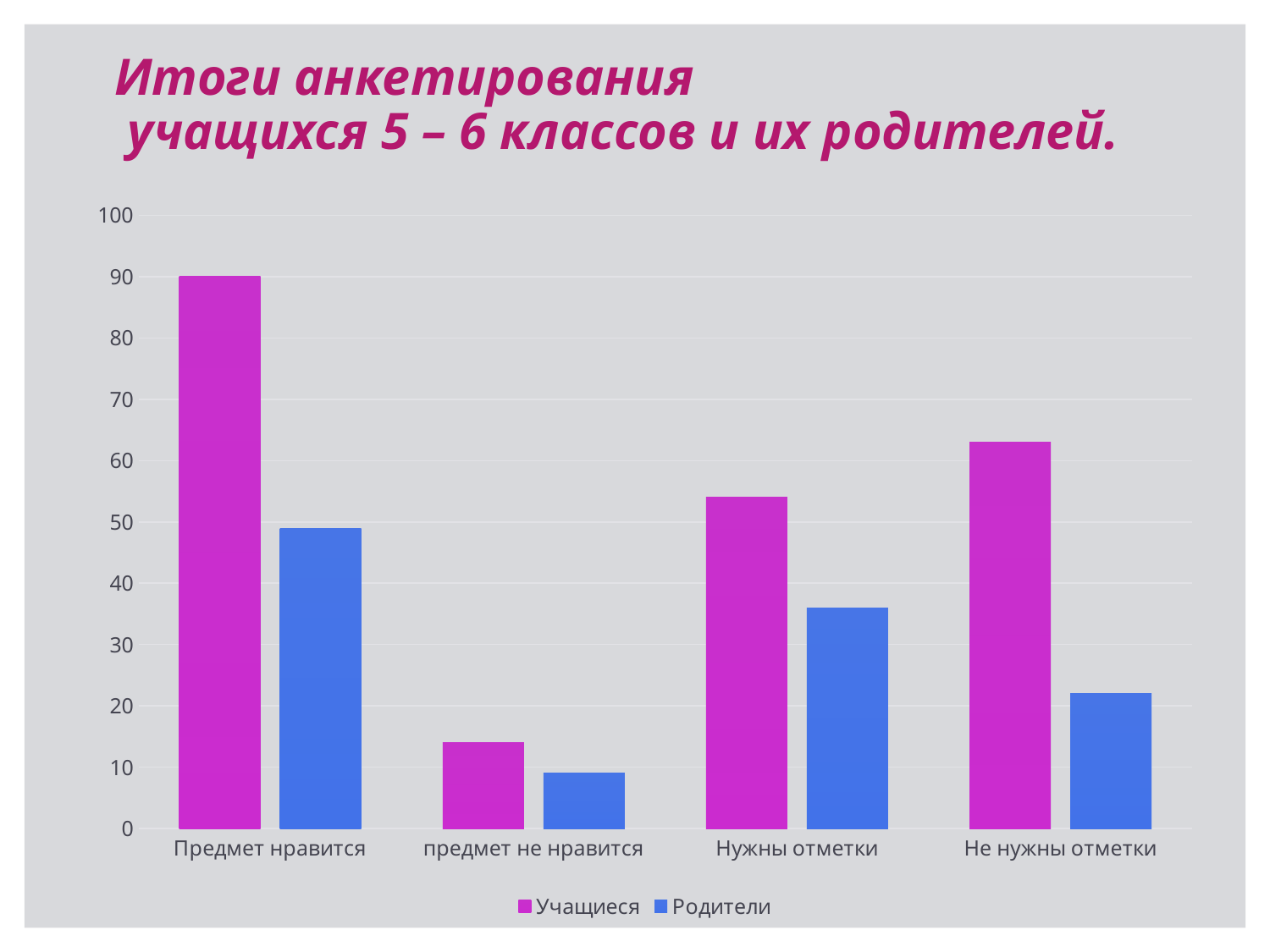
How many categories are shown on the x axis? 4 Which category has the lowest value for Учащиеся? предмет не нравится Which category has the highest value for Учащиеся? Предмет нравится What kind of chart is shown on the slide? bar chart How many series does the legend list? 2 Which category has the highest value for Родители? Предмет нравится Is the value for Родители in Нужны отметки greater or less than 40? less In the category Нужны отметки, which series has the larger value, Учащиеся or Родители? Учащиеся Is the value for Учащиеся in Не нужны отметки greater or less than 60? greater Is the value for Учащиеся in Предмет нравится greater or less than 80? greater Which category has the lowest value for Родители? предмет не нравится What are the two series named in the legend? Учащиеся and Родители